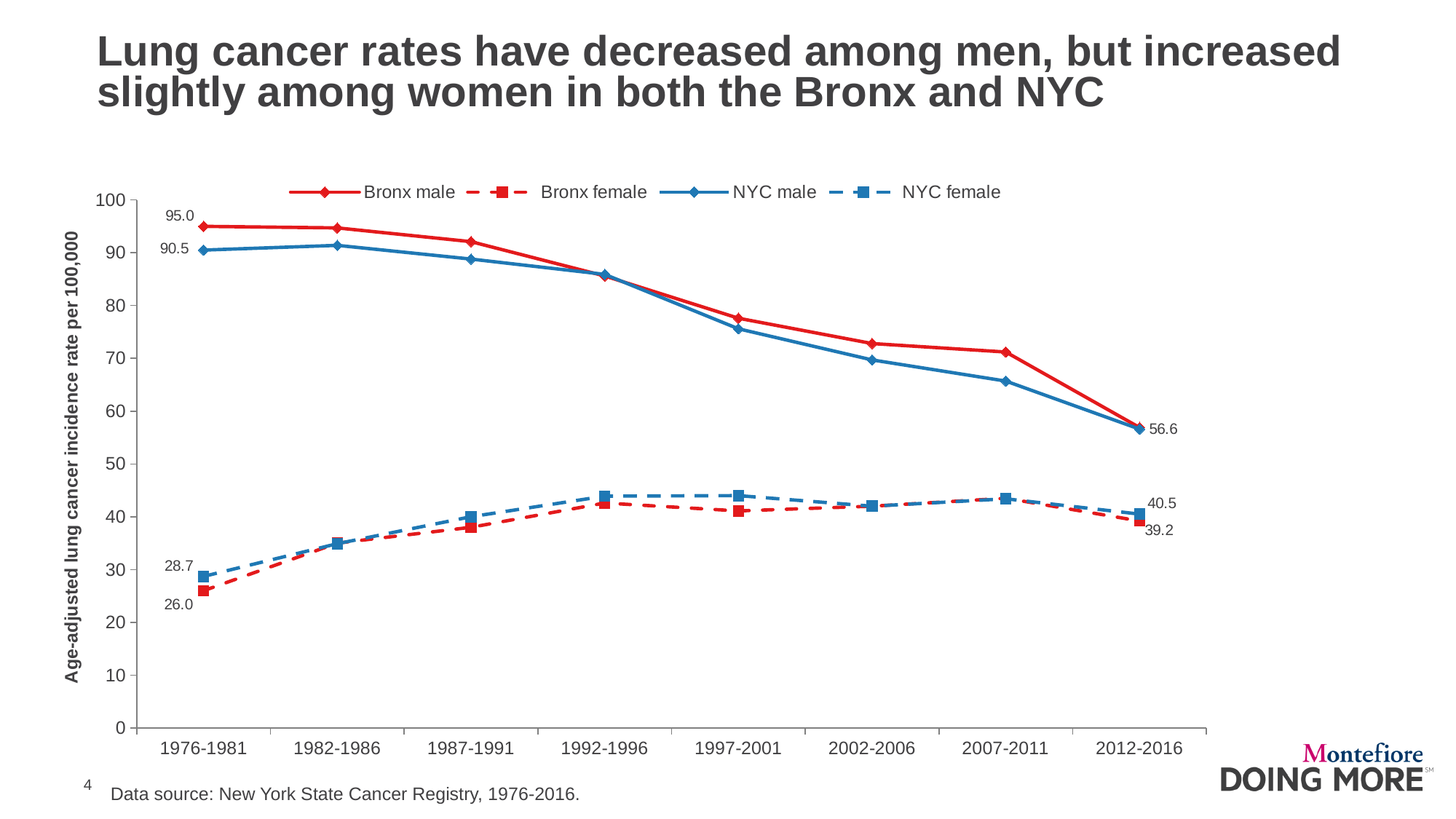
What is the Bronx female lung cancer incidence rate for 2012-2016? 39.2 What is the Bronx male lung cancer incidence rate for 1976-1981? 95.0 Is the NYC male rate for 2007-2011 greater or less than 70? less How many time periods are shown on the x axis? 8 What is the Bronx female lung cancer incidence rate for 1976-1981? 26.0 Does the Bronx male rate rise or fall from 1976-1981 to 2012-2016? fall What is the NYC male lung cancer incidence rate for 1976-1981? 90.5 What kind of chart is shown on the slide? line chart What is the NYC female lung cancer incidence rate for 2012-2016? 40.5 In 1976-1981, which is higher: the Bronx female rate or the NYC female rate? NYC female How much higher is the Bronx male rate than the NYC male rate in 1976-1981? 4.5 How many series does the legend list? 4